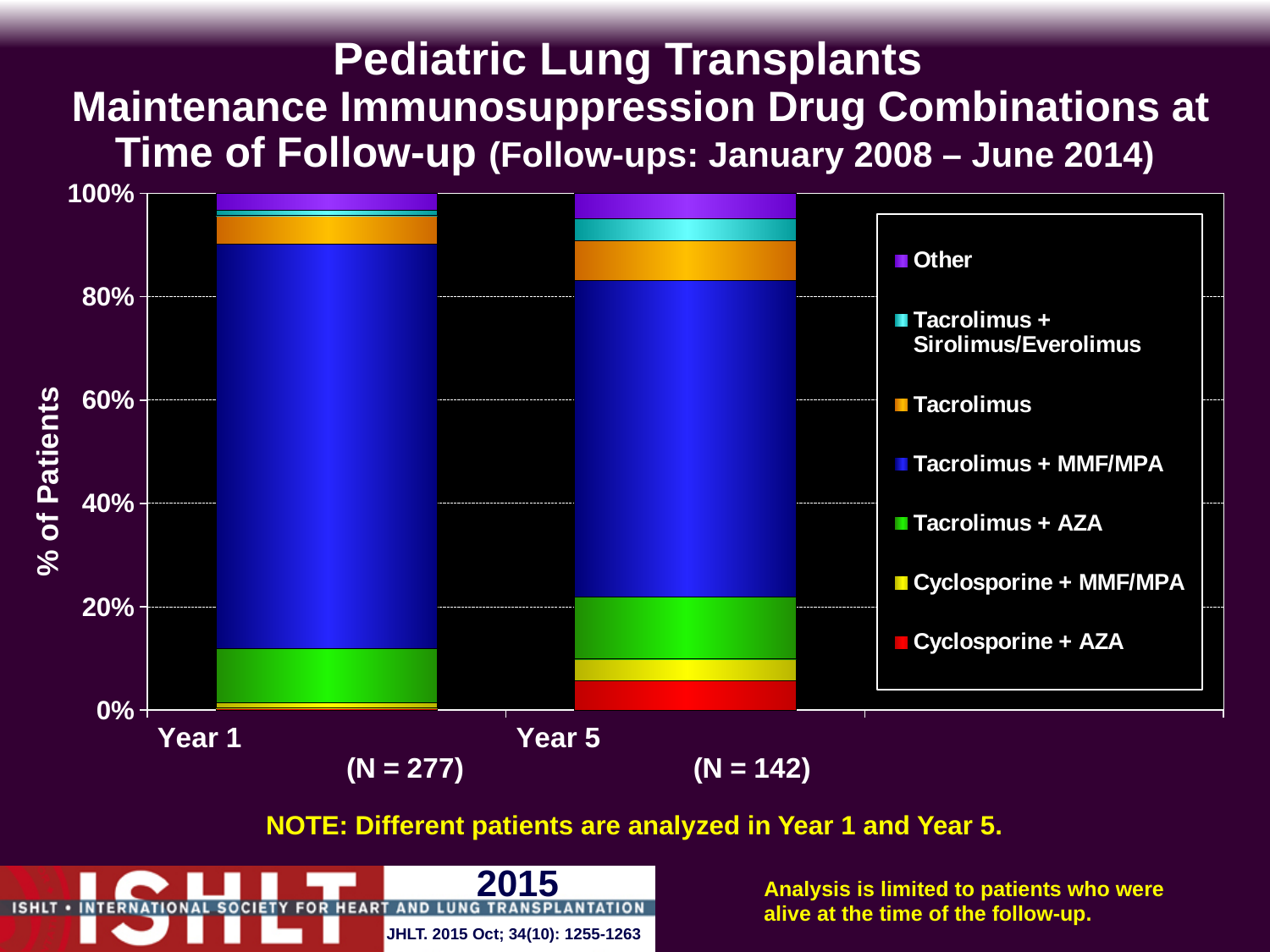
Is the share of Tacrolimus + MMF/MPA in Year 1 greater or less than 60%? greater Which drug combination makes up the largest share of patients in Year 5? Tacrolimus + MMF/MPA Is the share of Cyclosporine + AZA larger in Year 1 or in Year 5? Year 5 Is the share of Tacrolimus + MMF/MPA larger in Year 1 or in Year 5? Year 1 How many bars (time points) are plotted on the chart? 2 How many drug combination series does the legend list? 7 Is the share of Tacrolimus + AZA in Year 5 greater or less than 20%? less What is the number of patients (N) for the Year 1 bar? N = 277 What kind of chart is shown on the slide? Stacked bar chart What is the number of patients (N) for the Year 5 bar? N = 142 What is the label on the vertical axis of the chart? % of Patients Which drug combination makes up the largest share of patients in Year 1? Tacrolimus + MMF/MPA